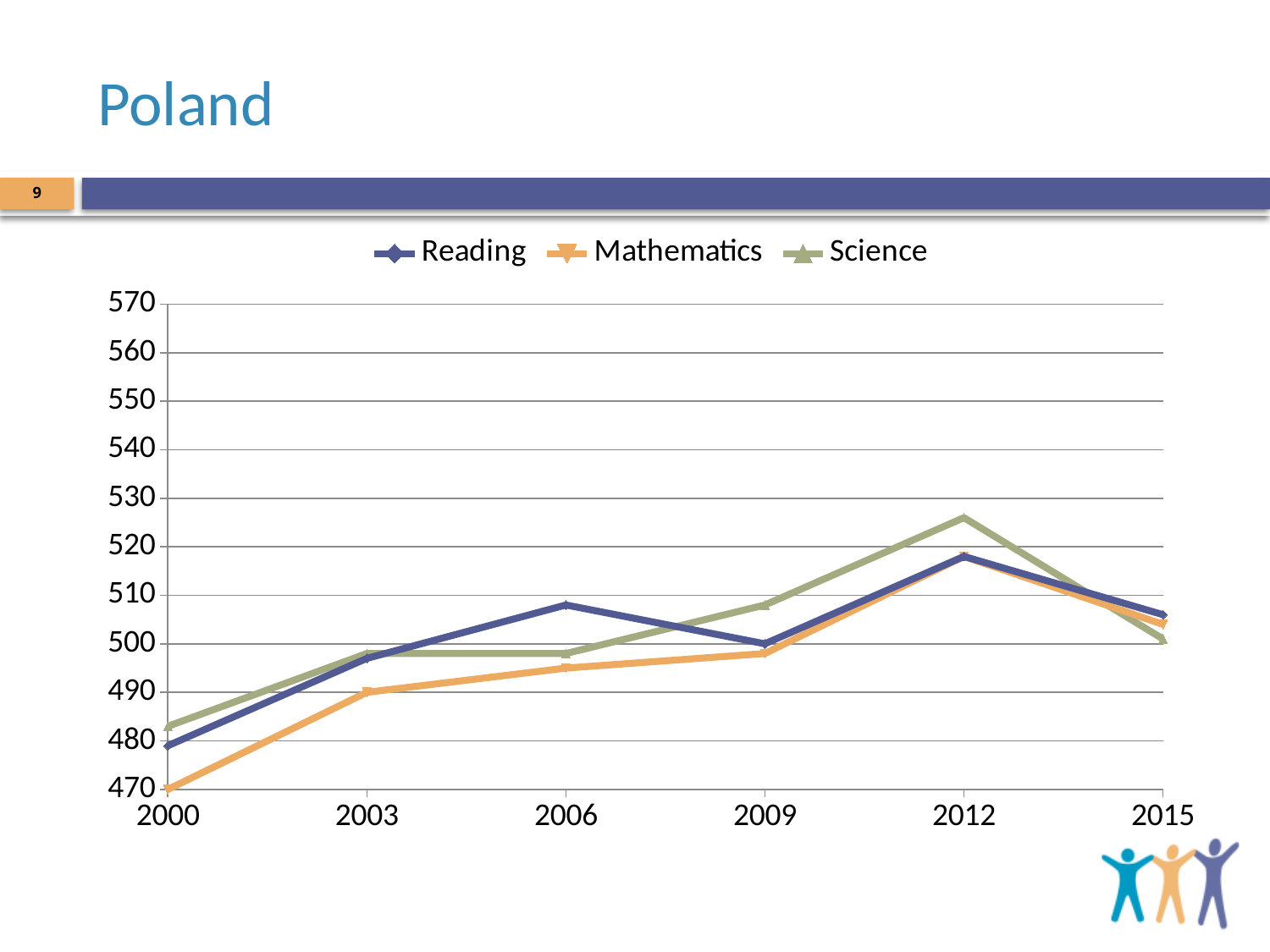
How many series does the legend list? 3 What kind of chart is shown on the slide? line chart Is the value for Science in 2012 greater or less than 520? greater In 2012, which is larger, Science or Reading? Science In which year does the Science series reach its highest value? 2012 In 2000, which is larger, Reading or Mathematics? Reading What is the title of the slide? Poland How many years are plotted along the x axis? 6 Which series are listed in the legend? Reading, Mathematics, Science Is the value for Reading in 2000 greater or less than 470? greater Is the value for Mathematics in 2003 greater or less than 500? less In which year is the Mathematics series at its lowest value? 2000